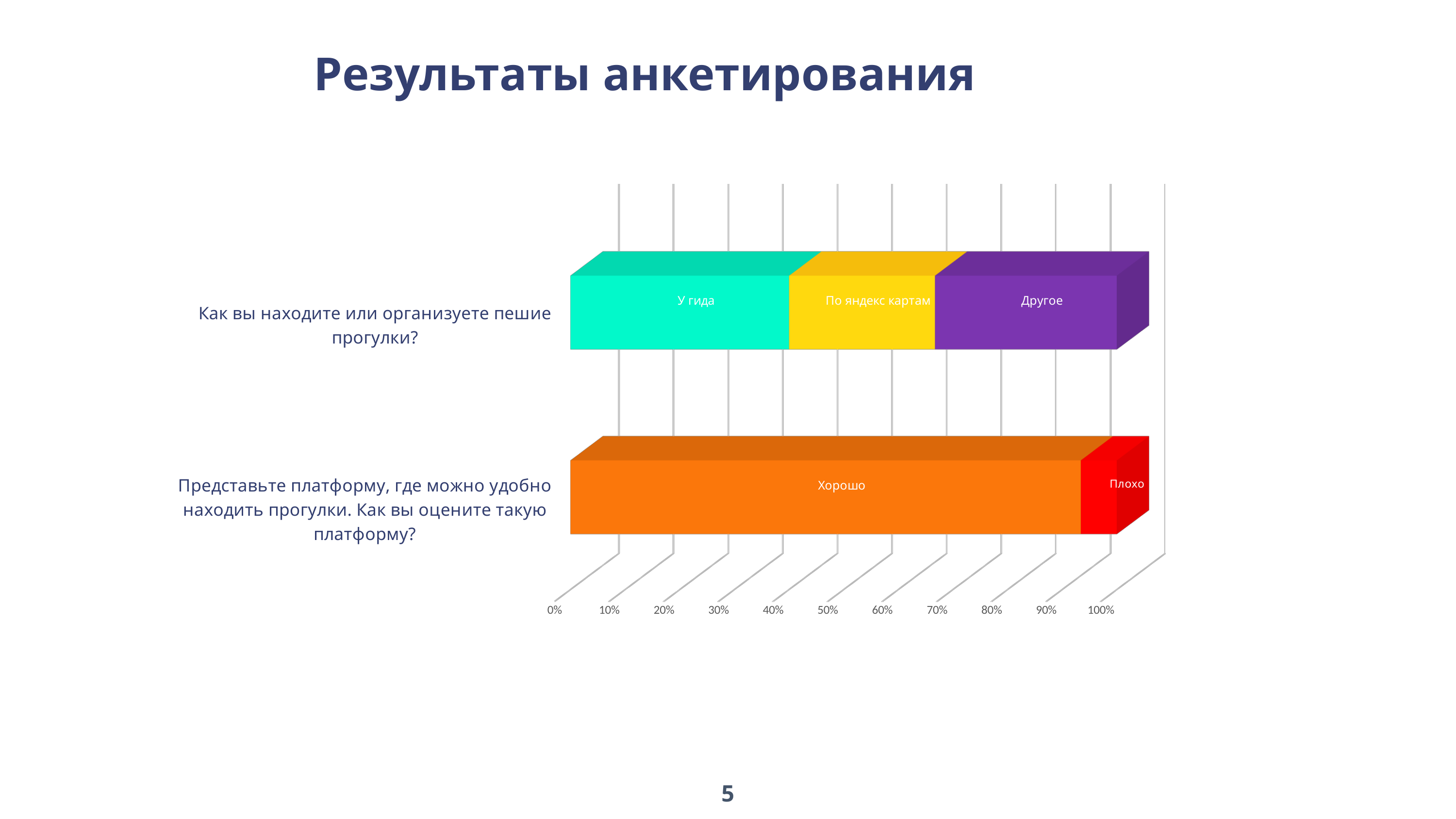
Is the share for "У гида" greater or less than 30%? greater How many answer segments make up the bar for "Как вы находите или организуете пешие прогулки?"? 3 In the bar for "Как вы находите или организуете пешие прогулки?", which answer has the largest share? У гида How many survey questions (categories) are plotted on the chart? 2 Is the share for "Хорошо" greater or less than 80%? greater How many answer segments make up the bar for "Представьте платформу, где можно удобно находить прогулки. Как вы оцените такую платформу?"? 2 What is the title of the slide? Результаты анкетирования Is the share for "Плохо" greater or less than 20%? less In the bar for the platform rating question, which answer is larger: "Хорошо" or "Плохо"? Хорошо What colour is the "Плохо" segment? Red In the bar for "Как вы находите или организуете пешие прогулки?", which is larger: "У гида" or "По яндекс картам"? У гида What kind of chart is shown on the slide? Stacked bar chart